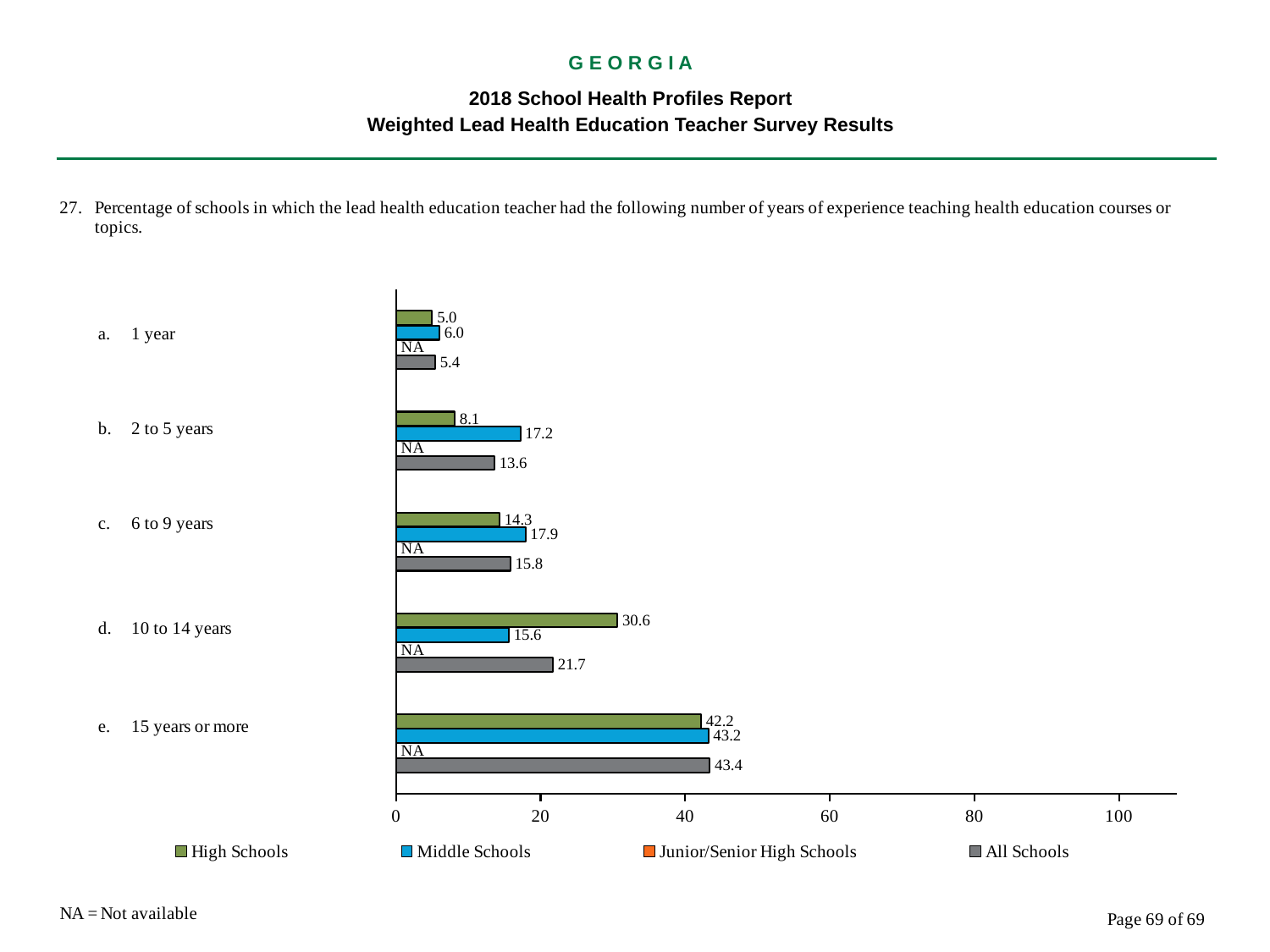
What kind of chart is shown on the slide? Bar chart Which category has the highest value for All Schools? 15 years or more Which category has the lowest value for High Schools? 1 year What is the difference between the High Schools and Middle Schools values in the '10 to 14 years' category? 15.0 What is the value for Middle Schools in the '2 to 5 years' category? 17.2 How many experience categories are shown on the chart? 5 What is the value for High Schools in the '10 to 14 years' category? 30.6 What is the value for All Schools in the '15 years or more' category? 43.4 How many series does the legend list? 4 Which is larger in the '6 to 9 years' category: the High Schools value or the Middle Schools value? Middle Schools What value is shown for Junior/Senior High Schools in the '1 year' category? NA Is the value for All Schools in the '10 to 14 years' category greater or less than 20? greater